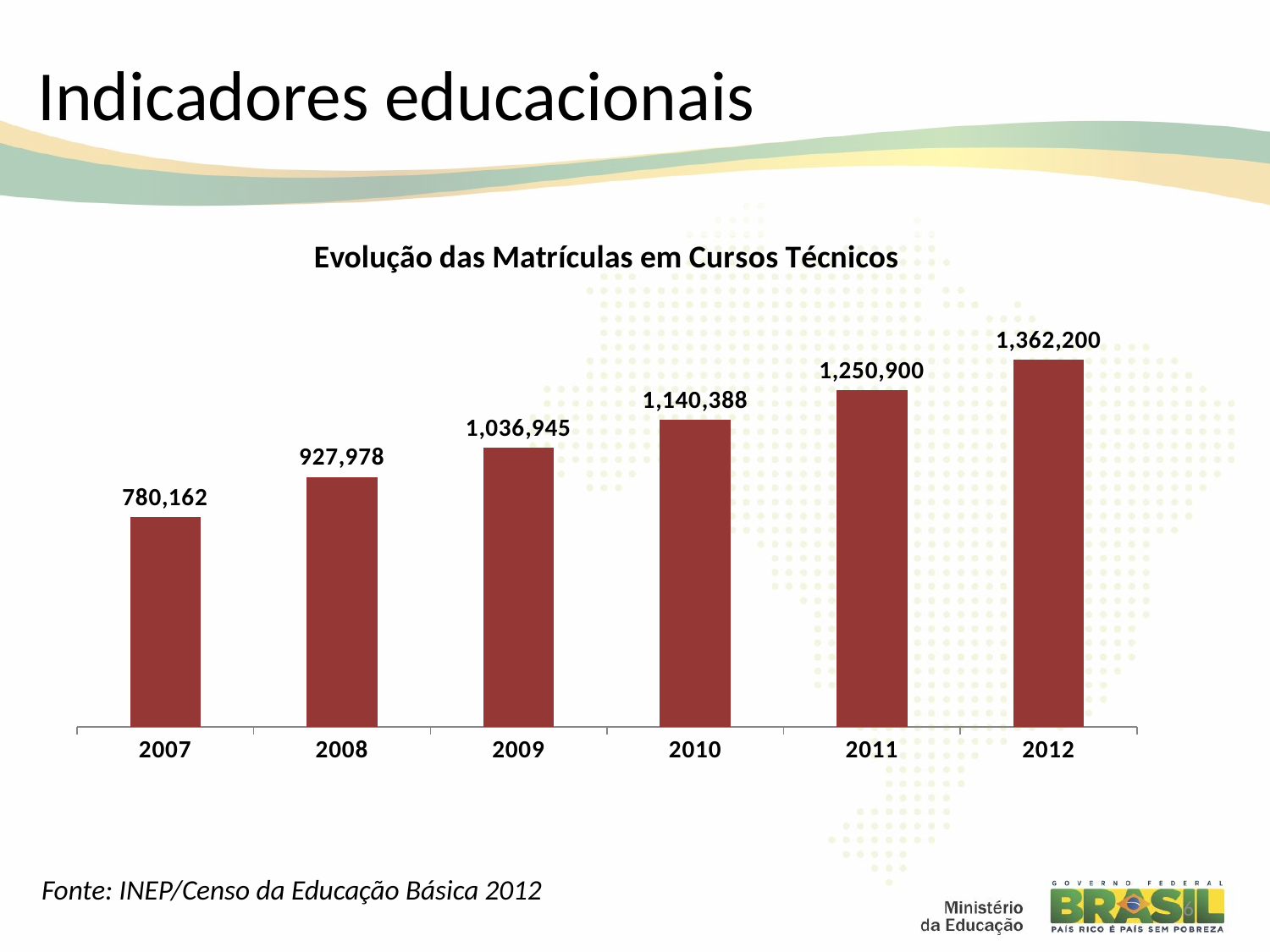
What is the value for 2012? 1,362,200 Which year has the lowest value? 2007 Do the values rise or fall from 2007 to 2012? rise What is the difference between the values for 2008 and 2007? 147,816 What is the difference between the values for 2012 and 2007? 582,038 What is the value for 2010? 1,140,388 What kind of chart is shown on the slide? bar chart What is the value for 2007? 780,162 What is the value for 2009? 1,036,945 Which is larger, the value for 2011 or the value for 2009? 2011 How many years are shown on the x axis? 6 Which year has the highest value? 2012